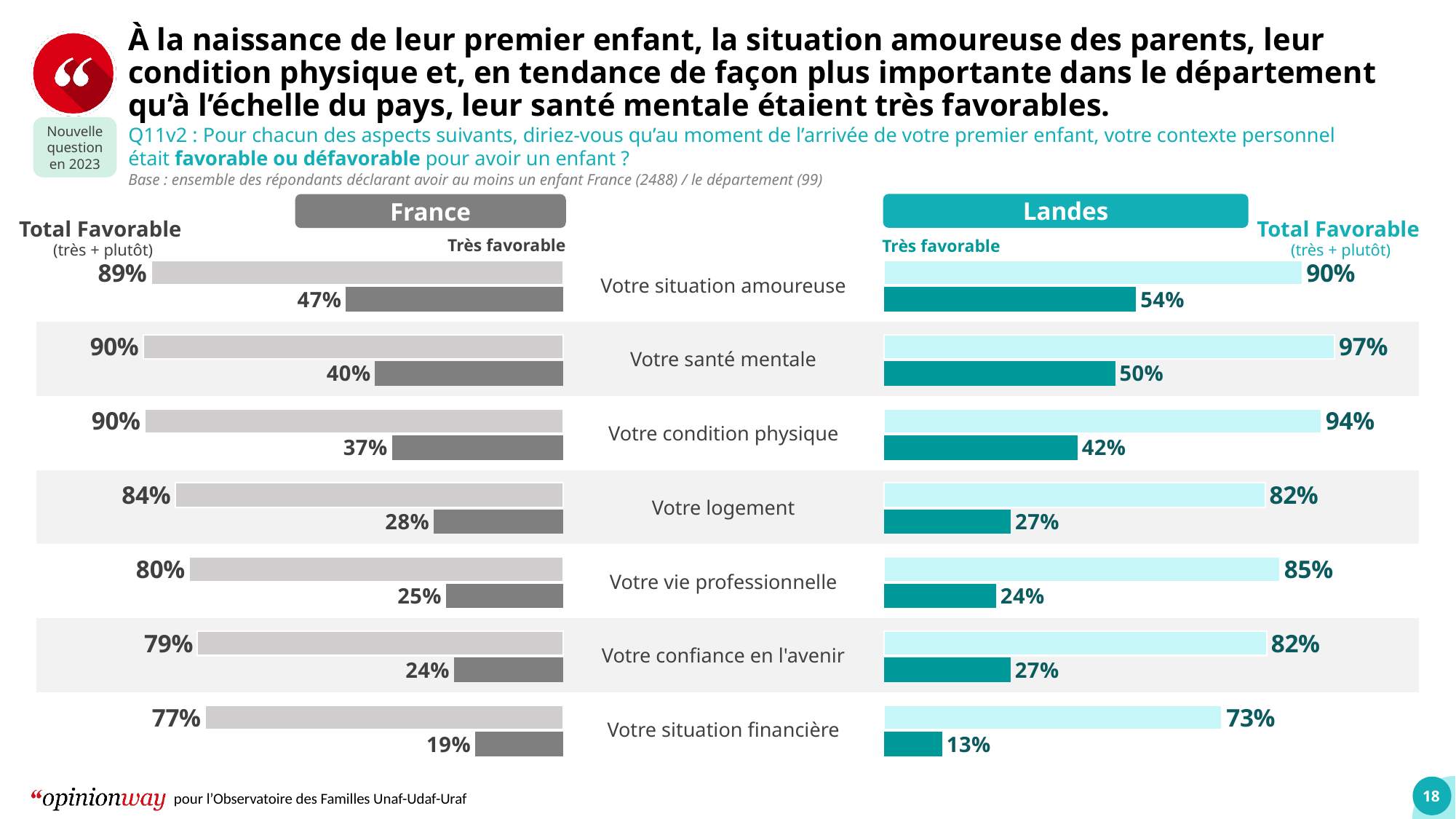
How many categories (aspects) are shown in each chart? 7 In the France chart, what is the Total Favorable value for "Votre situation amoureuse"? 89% What is the title of the right-hand chart? Landes What is the difference between the Landes and France Total Favorable values for "Votre santé mentale"? 7 points How many series does each chart show per category? 2 In the Landes chart, what is the Très favorable value for "Votre santé mentale"? 50% In the Landes chart, which category has the highest Total Favorable value? Votre santé mentale In the France chart, which category has the lowest Très favorable value? Votre situation financière For "Votre situation financière", which is larger: the France Total Favorable value or the Landes Total Favorable value? France In the France chart, what is the difference between the Total Favorable and Très favorable values for "Votre logement"? 56 points What kind of chart is used on this slide? Bar chart In the Landes chart, what is the Très favorable value for "Votre situation financière"? 13%